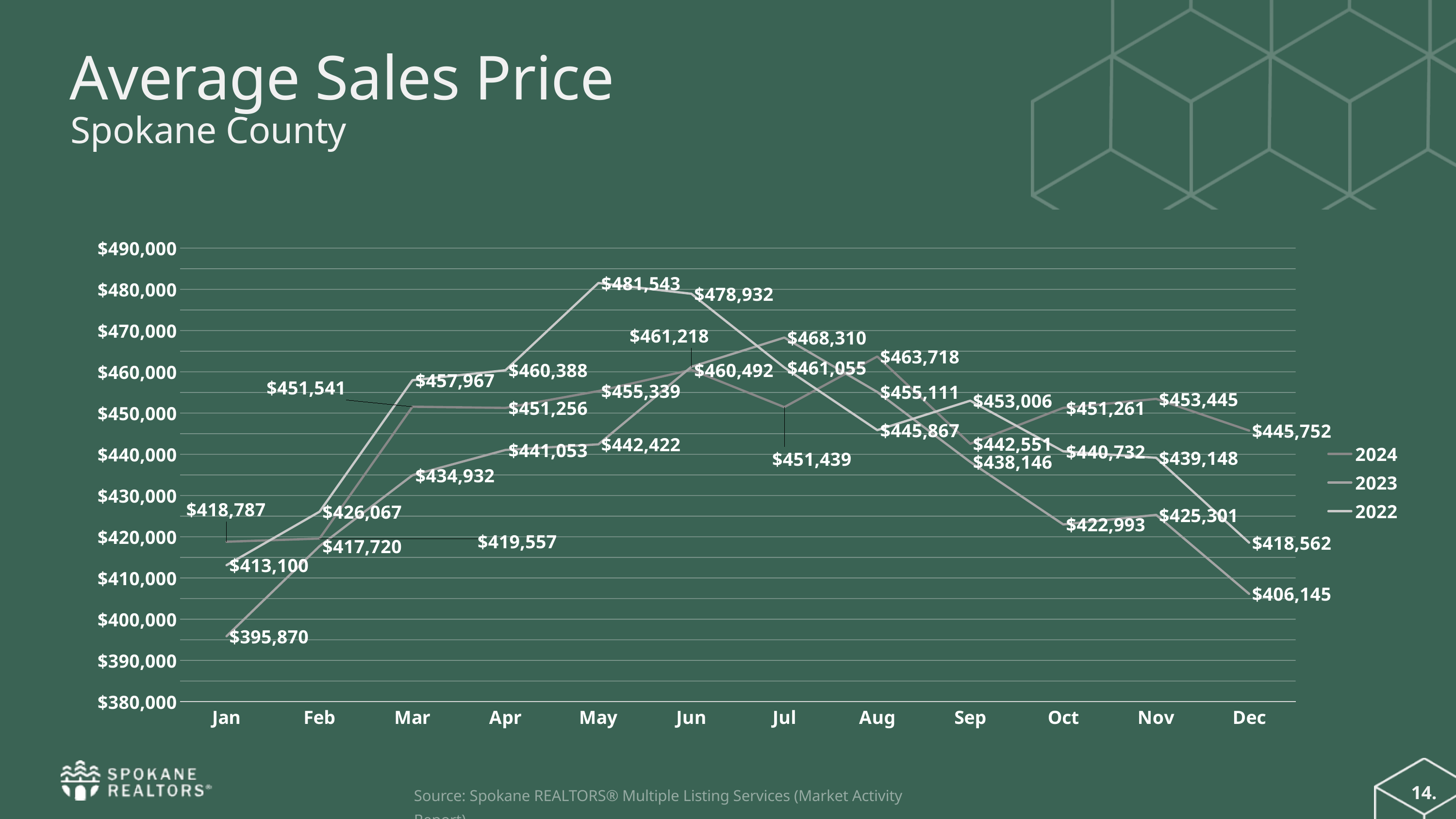
What is the lowest value labelled for Dec? $406,145 How many series does the legend list? 3 What is the lowest value labelled anywhere on the chart? $395,870 Is the highest value labelled for Jul greater or less than $460,000? greater What kind of chart is shown on the slide? line chart What is the highest value labelled for Dec? $445,752 In which month does the highest labelled value, $481,543, occur? May Which years are listed in the legend? 2024, 2023, 2022 What is the difference between the highest and lowest values labelled for Dec? $39,607 What is the highest value labelled anywhere on the chart? $481,543 In which month does the lowest labelled value, $395,870, occur? Jan How many months are shown along the x axis? 12